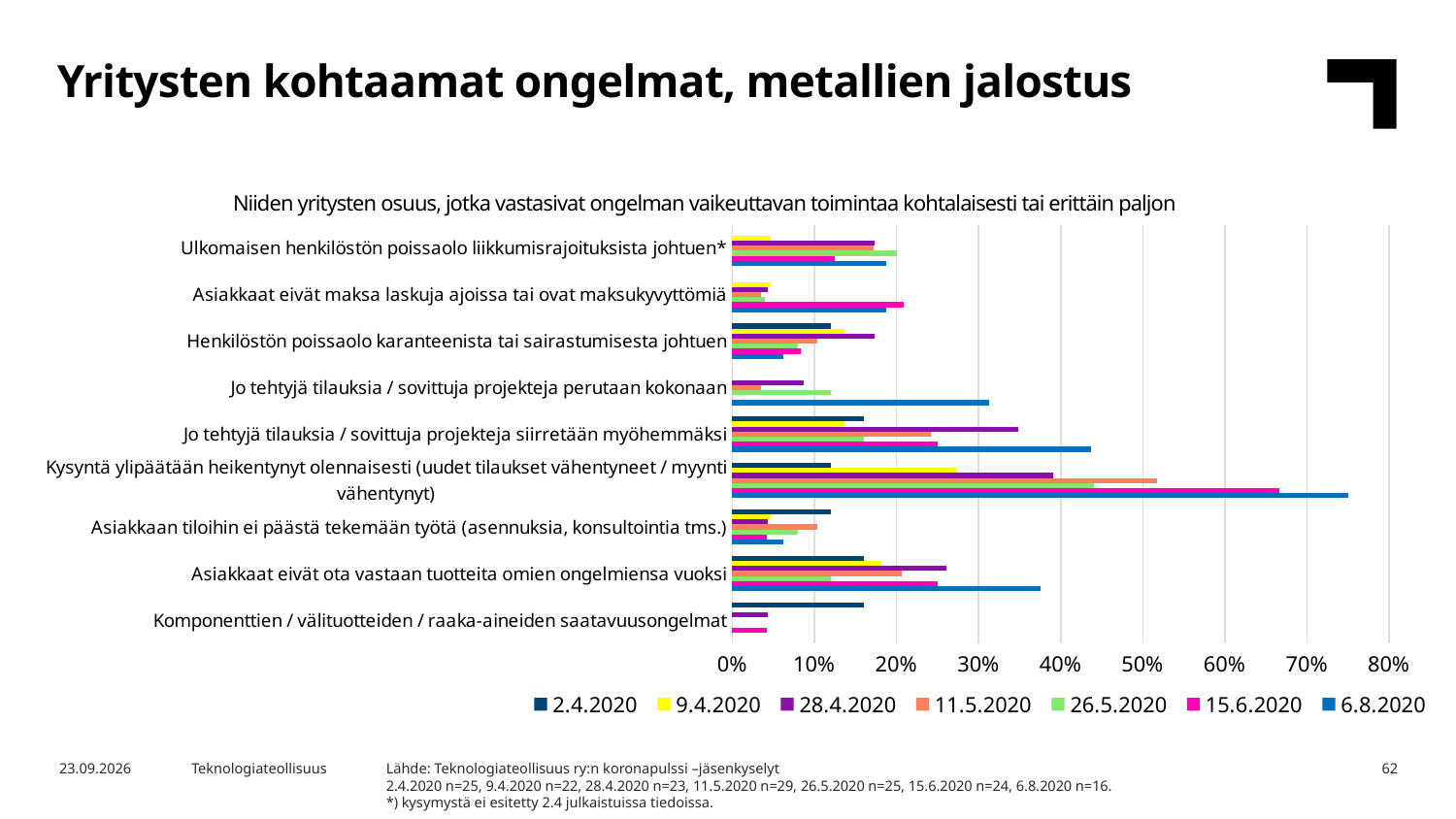
For 'Kysyntä ylipäätään heikentynyt olennaisesti', which is larger: the 2.4.2020 value or the 6.8.2020 value? 6.8.2020 Is the 6.8.2020 value for 'Asiakkaat eivät ota vastaan tuotteita omien ongelmiensa vuoksi' greater or less than 30%? greater Is the 6.8.2020 value for 'Jo tehtyjä tilauksia / sovittuja projekteja siirretään myöhemmäksi' greater or less than 40%? greater How many categories (problem types) are plotted on the chart? 9 Is the 6.8.2020 value for 'Komponenttien / välituotteiden / raaka-aineiden saatavuusongelmat' greater or less than 10%? less How many series does the legend list? 7 Which date is the last entry in the chart legend? 6.8.2020 Which category has the highest value for the 6.8.2020 series? Kysyntä ylipäätään heikentynyt olennaisesti (uudet tilaukset vähentyneet / myynti vähentynyt) For the category 'Kysyntä ylipäätään heikentynyt olennaisesti', which series has the highest value? 6.8.2020 What kind of chart is shown on the slide? bar chart What is the subtitle printed above the chart? Niiden yritysten osuus, jotka vastasivat ongelman vaikeuttavan toimintaa kohtalaisesti tai erittäin paljon